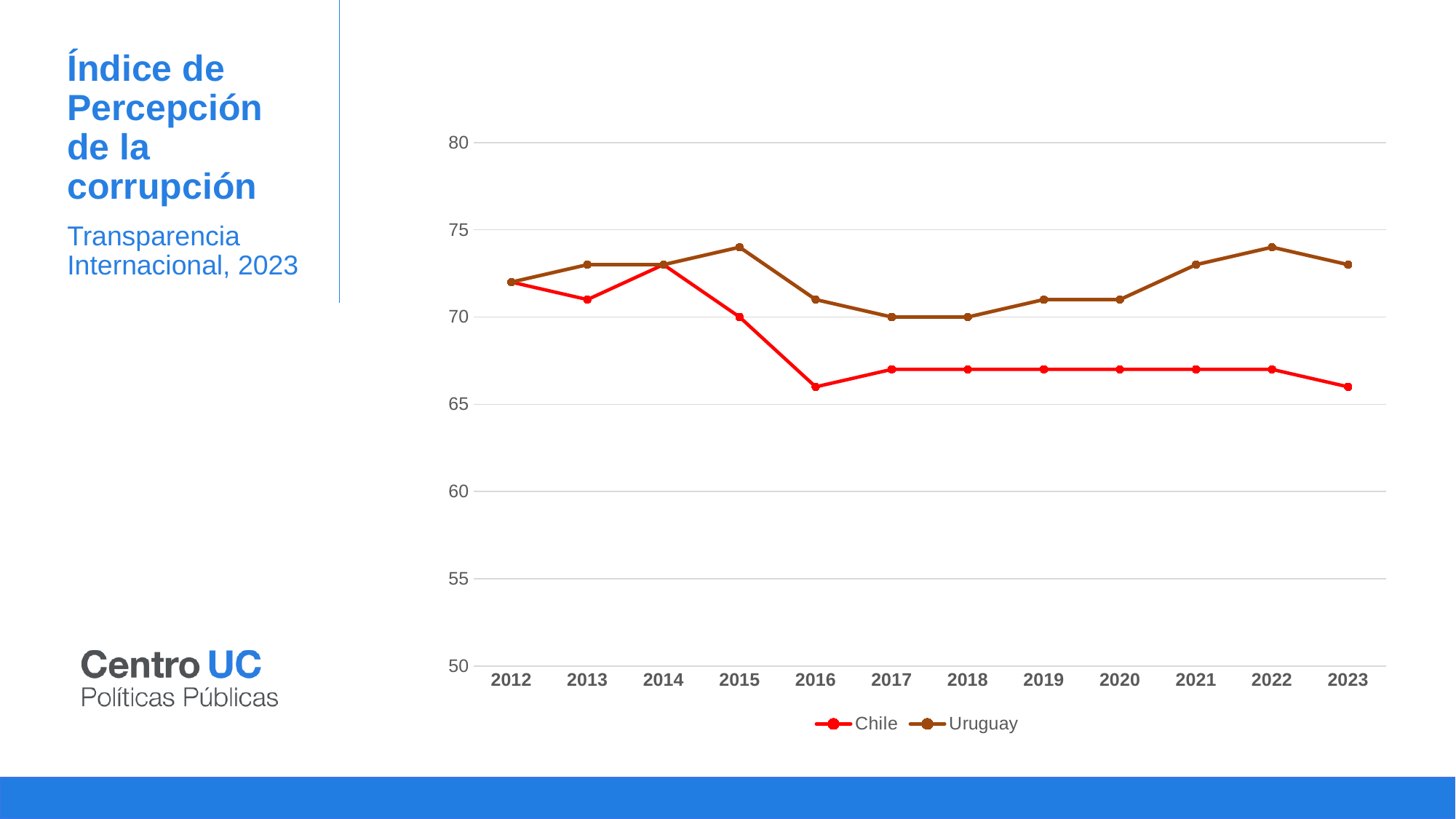
Is the value for Uruguay in 2022 greater or less than 75? less Is the value for Chile in 2016 greater or less than 70? less What colour is the Chile line in the legend? red What is the value for Chile in 2015? 70 How many series does the legend list? 2 In 2016, which series has the higher value, Chile or Uruguay? Uruguay How many years are shown on the x axis? 12 Does the Chile line rise or fall between 2014 and 2016? fall Does the Uruguay line rise or fall between 2018 and 2022? rise What kind of chart is shown on the slide? line chart Is the value for Uruguay in 2015 greater or less than 70? greater What is the value for Uruguay in 2017? 70